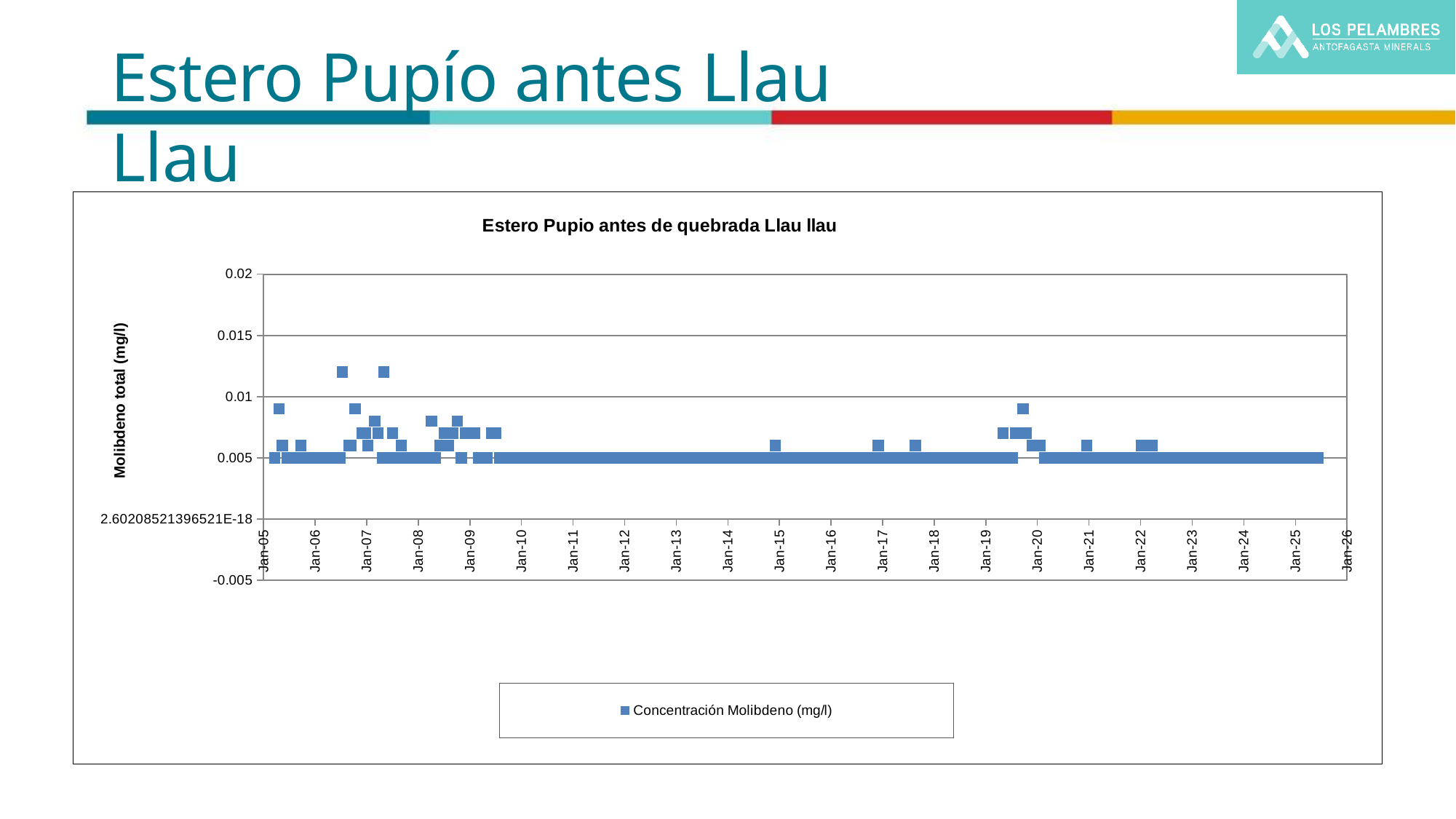
What is the maximum value shown on the y axis? 0.02 Is the highest plotted value on the chart greater or less than 0.015? less Is the highest value plotted between Jan-10 and Jan-15 greater or less than 0.01? less What value on the y axis do most of the plotted points lie on? 0.005 What is the title of the chart? Estero Pupio antes de quebrada Llau llau What kind of chart is shown on the slide? Scatter chart How many series does the chart legend list? 1 Is the highest value plotted between Jan-22 and Jan-26 greater or less than 0.01? less What is the series name shown in the chart legend? Concentración Molibdeno (mg/l) Which period has higher plotted values: Jan-06 to Jan-08 or Jan-23 to Jan-25? Jan-06 to Jan-08